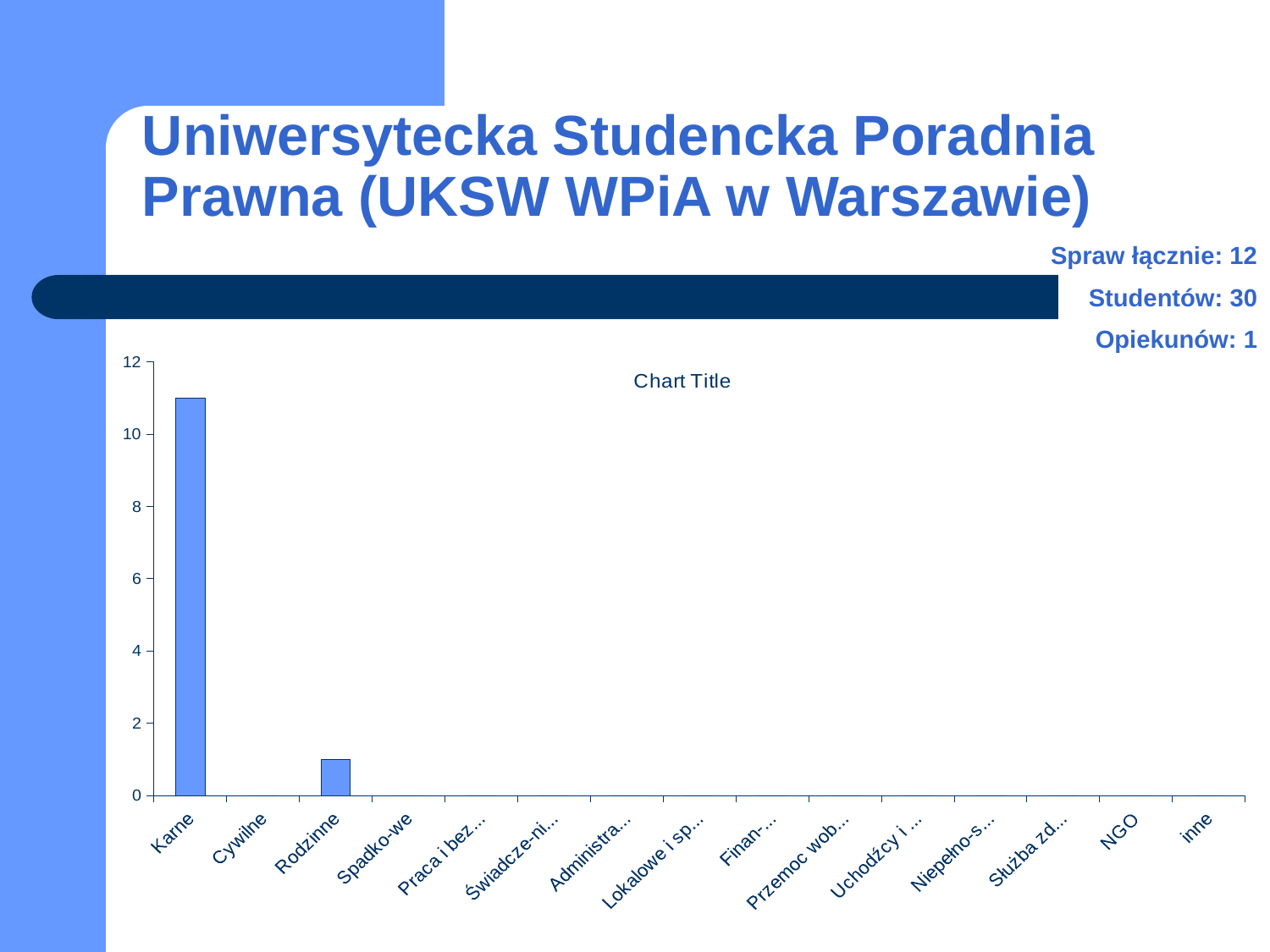
Is the value for Karne greater or less than 12? less What kind of chart is shown on the slide? bar chart Is the value for Karne greater or less than 10? greater Is the value for Rodzinne greater or less than 4? less How many categories are shown on the x axis of the chart? 15 Which is larger, the value for Karne or the value for Rodzinne? Karne Which is larger, the value for Rodzinne or the value for Cywilne? Rodzinne What is the title shown on the chart? Chart Title What is the highest value shown on the chart's vertical axis? 12 Which category has the highest value in the chart? Karne